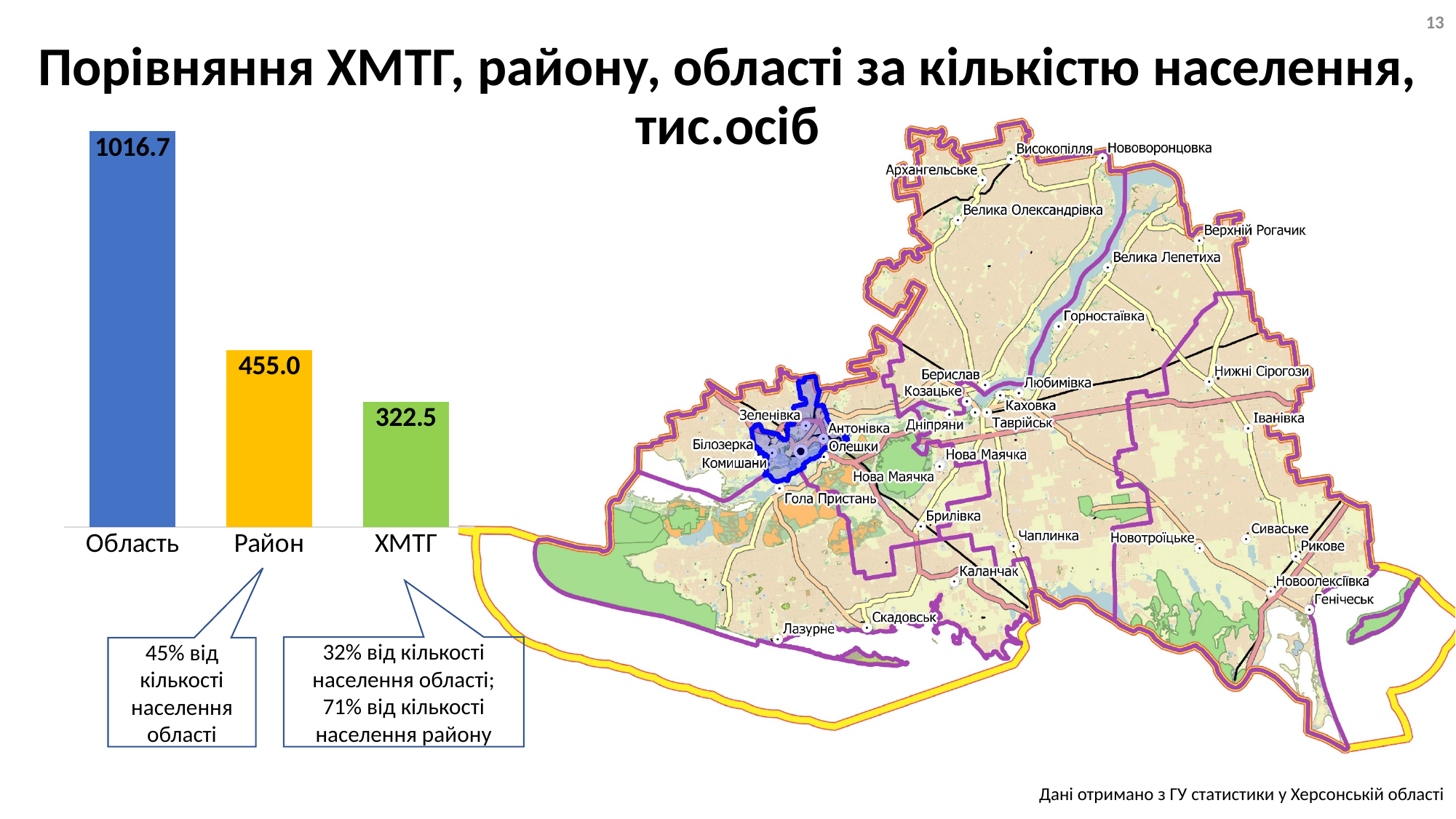
What is the difference between the values for Район and ХМТГ? 132.5 What is the population value shown for ХМТГ? 322.5 What kind of chart is shown on the slide? bar chart How many categories are shown in the bar chart? 3 What is the population value shown for Область? 1016.7 Which category has the lowest value in the bar chart? ХМТГ According to the callout under the ХМТГ bar, what share of the district (район) population does ХМТГ represent? 71% Which category has the highest value in the bar chart? Область What is the difference between the values for Область and Район? 561.7 What is the population value shown for Район? 455.0 Which is larger, the value for Район or the value for ХМТГ? Район Do the bar values rise or fall from left to right across the categories? fall